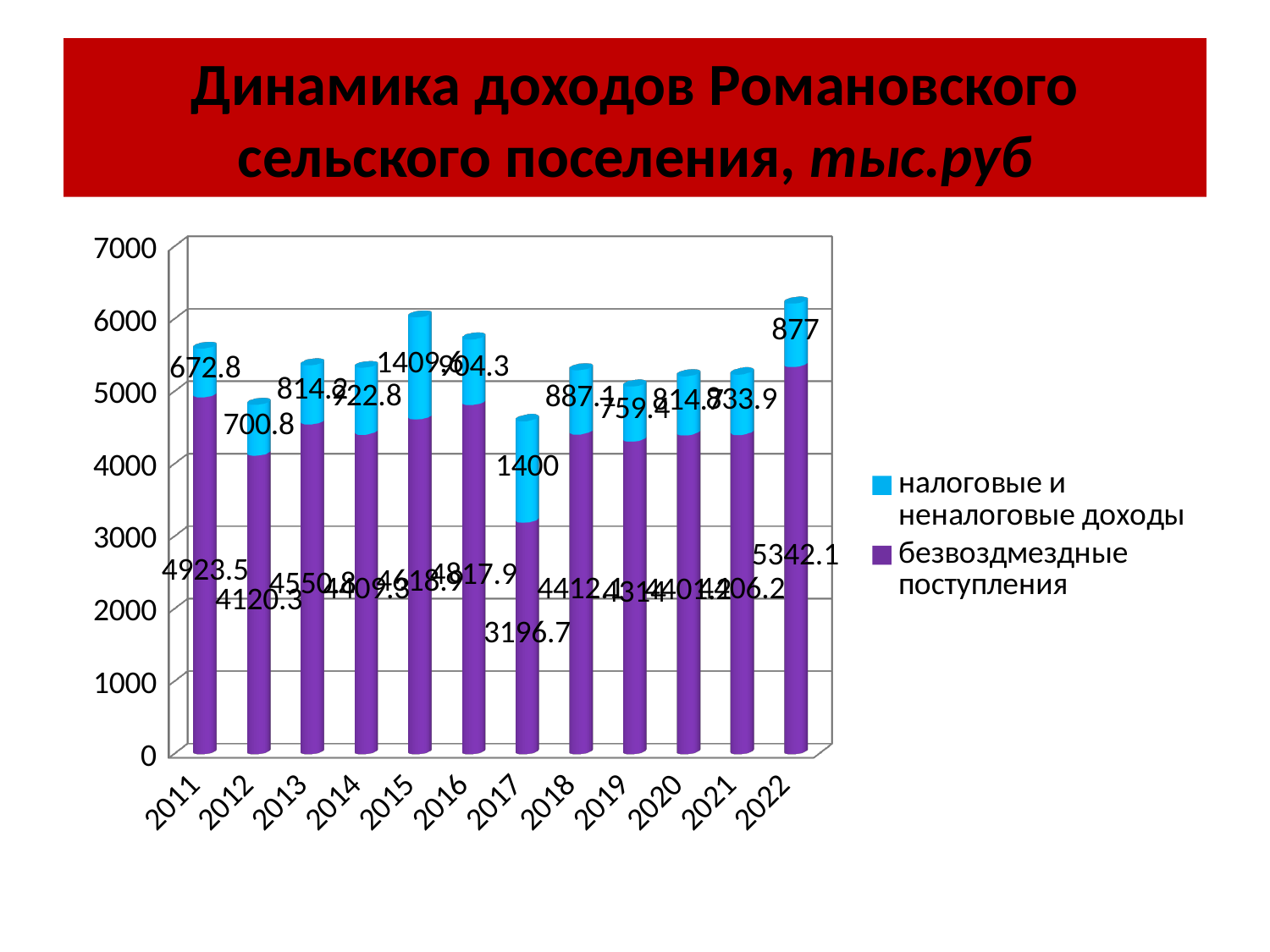
Is the total of the stacked bar for 2017 greater or less than 5000? less What is the total of the stacked bar for 2022? 6219.1 What is the value of налоговые и неналоговые доходы for 2021? 833.9 Which year has the highest value of безвоздмездные поступления? 2022 What is the difference between безвоздмездные поступления in 2022 and in 2017? 2145.4 How many series does the legend list? 2 What is the value of безвоздмездные поступления for 2011? 4923.5 What is the value of налоговые и неналоговые доходы for 2017? 1400 What is the value of безвоздмездные поступления for 2022? 5342.1 What type of chart is shown on the slide? Stacked bar chart Which year has the lowest value of безвоздмездные поступления? 2017 How many years are shown on the x axis of the chart? 12